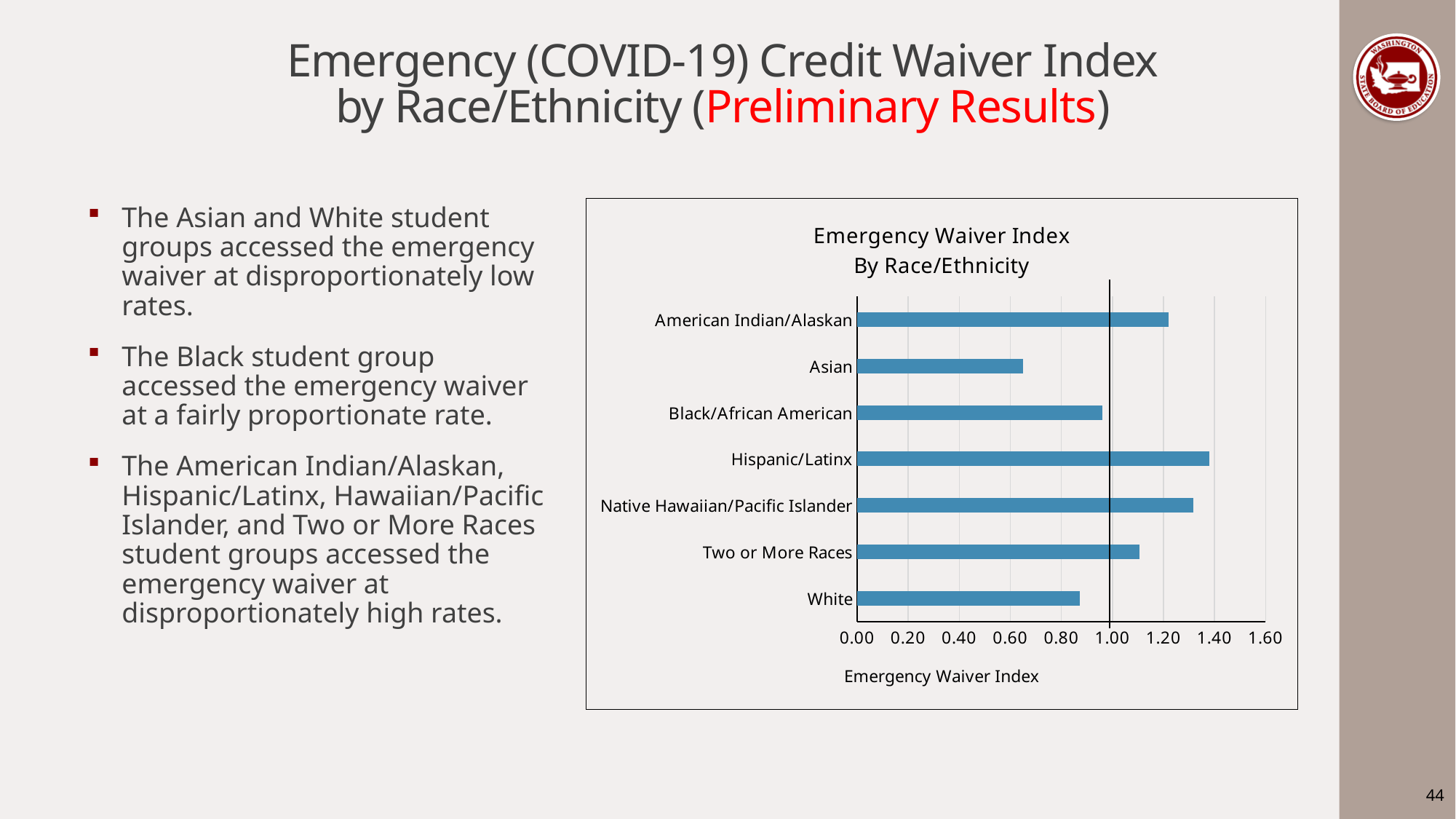
Is the Emergency Waiver Index for Native Hawaiian/Pacific Islander students greater or less than 1.20? greater What kind of chart is shown on the slide? Bar chart Is the Emergency Waiver Index for American Indian/Alaskan students greater or less than 1.00? greater Which race/ethnicity group has the lowest Emergency Waiver Index? Asian Is the Emergency Waiver Index for Hispanic/Latinx students greater or less than 1.20? greater Which group has a higher Emergency Waiver Index, Asian or White? White Which race/ethnicity group has the highest Emergency Waiver Index? Hispanic/Latinx Which group has a higher Emergency Waiver Index, American Indian/Alaskan or Two or More Races? American Indian/Alaskan What is the label on the horizontal axis of the chart? Emergency Waiver Index How many race/ethnicity categories are plotted in the chart? 7